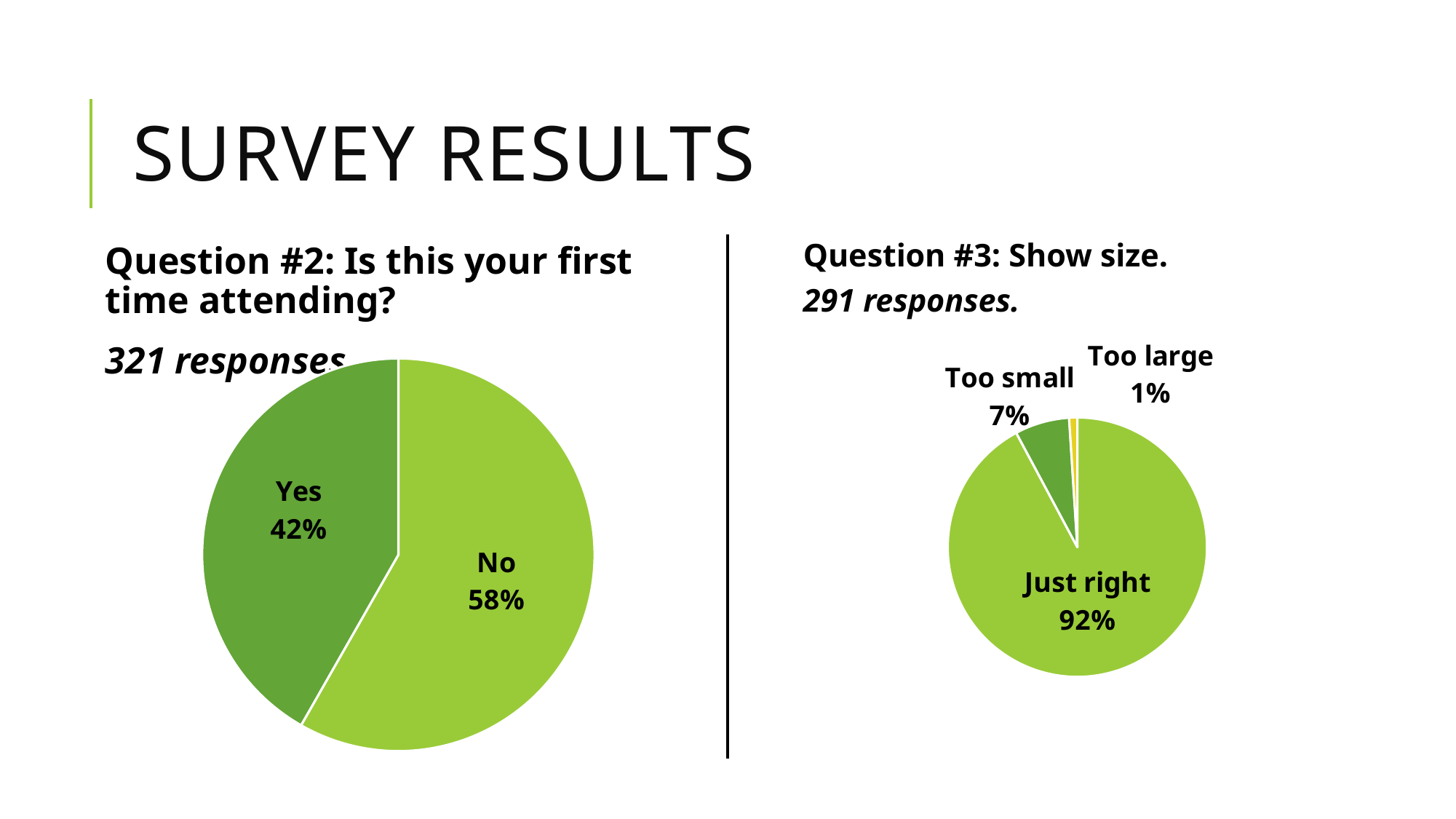
In the right pie chart (Question #3: Show size), what share of responses is "Too large"? 1% In the right pie chart (Question #3: Show size), what share of responses is "Too small"? 7% In the left pie chart (Question #2: Is this your first time attending?), what share of responses is "Yes"? 42% In the right pie chart (Question #3: Show size), what share of responses is "Just right"? 92% In the right pie chart (Question #3), which category has the smallest slice? Too large In the left pie chart (Question #2: Is this your first time attending?), what share of responses is "No"? 58% In the right pie chart (Question #3), which category has the largest slice? Just right How many slices does the right pie chart (Question #3: Show size) have? 3 What kind of chart is used for Question #3: Show size? Pie chart How many slices does the left pie chart (Question #2) have? 2 In the left pie chart (Question #2), what is the difference in percentage points between the No and Yes slices? 16 In the left pie chart (Question #2), which slice is larger, Yes or No? No